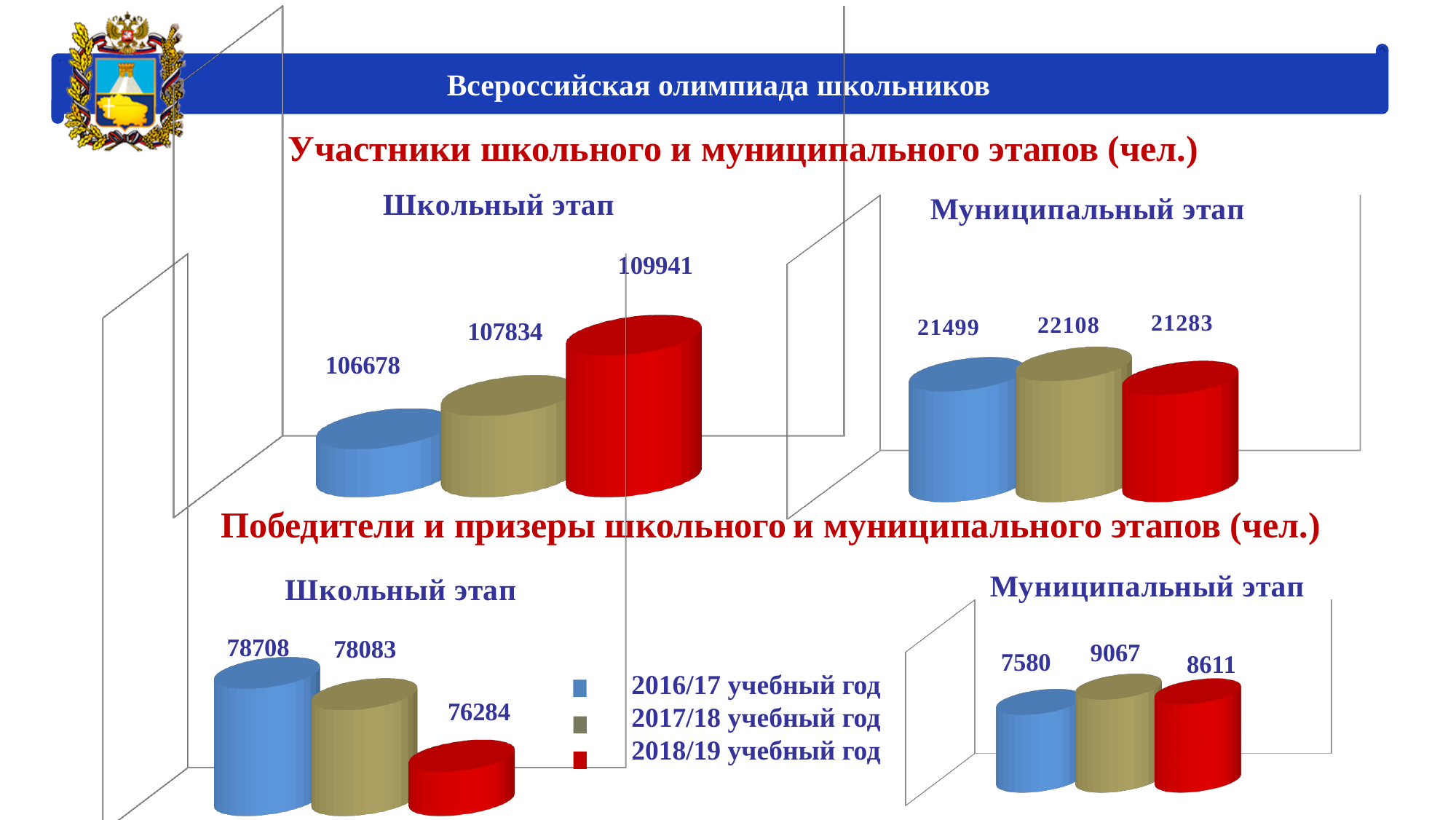
What type of chart is used in the 'Победители и призеры' section, 'Школьный этап'? bar chart In the 'Участники' section, 'Муниципальный этап' chart, which is larger: the value for 2016/17 or for 2018/19? 2016/17 In the 'Участники школьного и муниципального этапов' section, 'Муниципальный этап' chart, what is the value for 2017/18 учебный год? 22108 In the 'Участники' section, 'Школьный этап' chart, do the values rise or fall from 2016/17 to 2018/19? rise In the 'Победители и призеры школьного и муниципального этапов' section, 'Муниципальный этап' chart, what is the value for 2018/19 учебный год? 8611 In the 'Победители и призеры школьного и муниципального этапов' section, 'Школьный этап' chart, what is the value for 2016/17 учебный год? 78708 In the 'Участники школьного и муниципального этапов' section, 'Школьный этап' chart, what is the value for 2018/19 учебный год? 109941 In the 'Участники' section, 'Муниципальный этап' chart, which academic year has the highest value? 2017/18 учебный год In the 'Участники' section, 'Школьный этап' chart, what is the difference between the 2018/19 and 2016/17 values? 3263 How many academic years does the legend list? 3 In the 'Победители и призеры' section, 'Муниципальный этап' chart, what is the difference between the 2017/18 and 2016/17 values? 1487 In the 'Победители и призеры' section, 'Школьный этап' chart, which academic year has the lowest value? 2018/19 учебный год